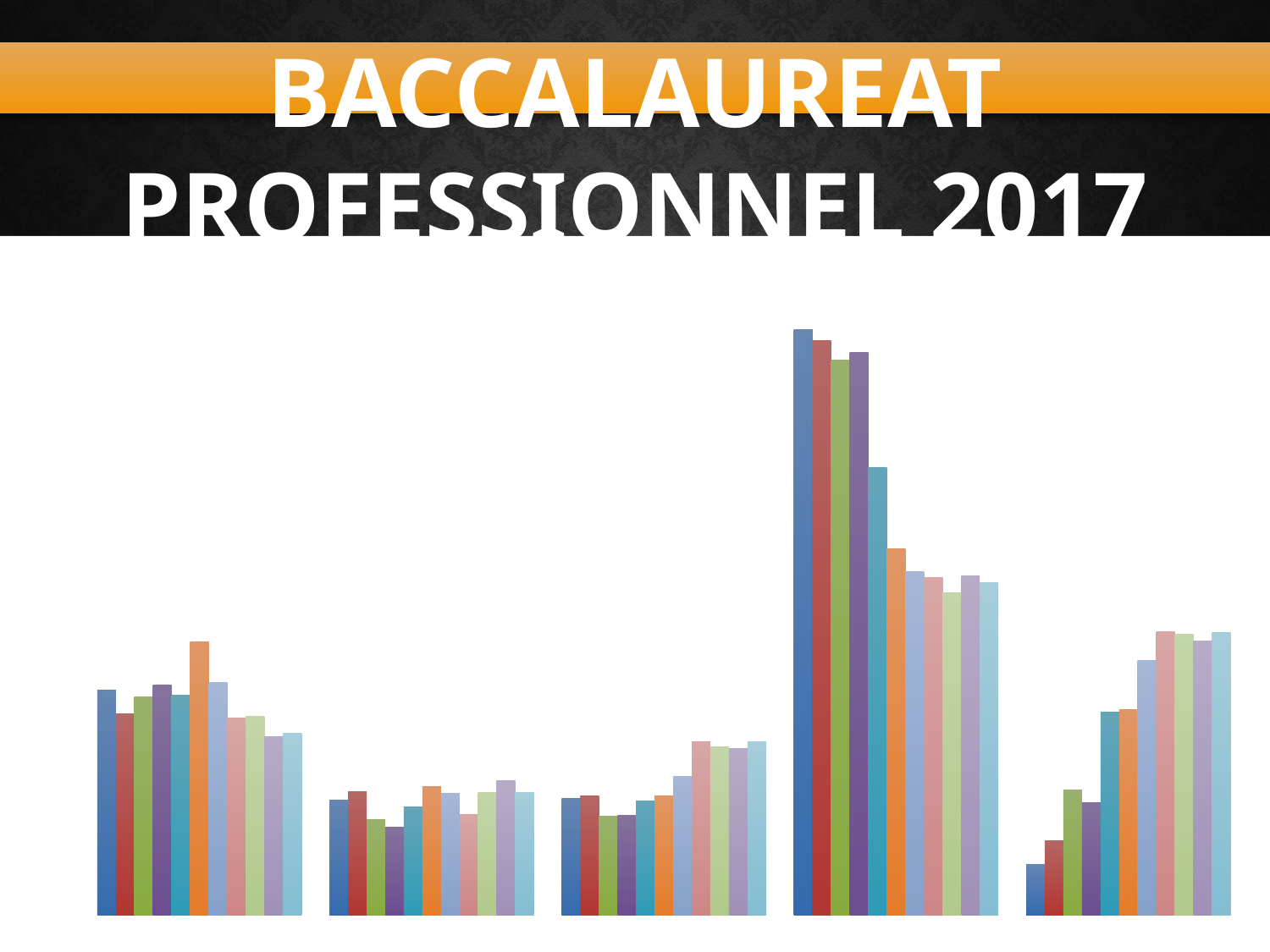
Within the fourth group from the left, do the bars generally rise or fall from left to right? fall How many groups of bars does the chart contain? 5 Does the chart show any axis labels or data labels? No Does the chart display a legend? No What kind of chart is shown on the slide? bar chart Which group of bars, counted from the left, contains the tallest bars on the chart? the fourth group How many bars are there in each group of the chart? 11 Within the rightmost group, do the bars generally rise or fall from left to right? rise